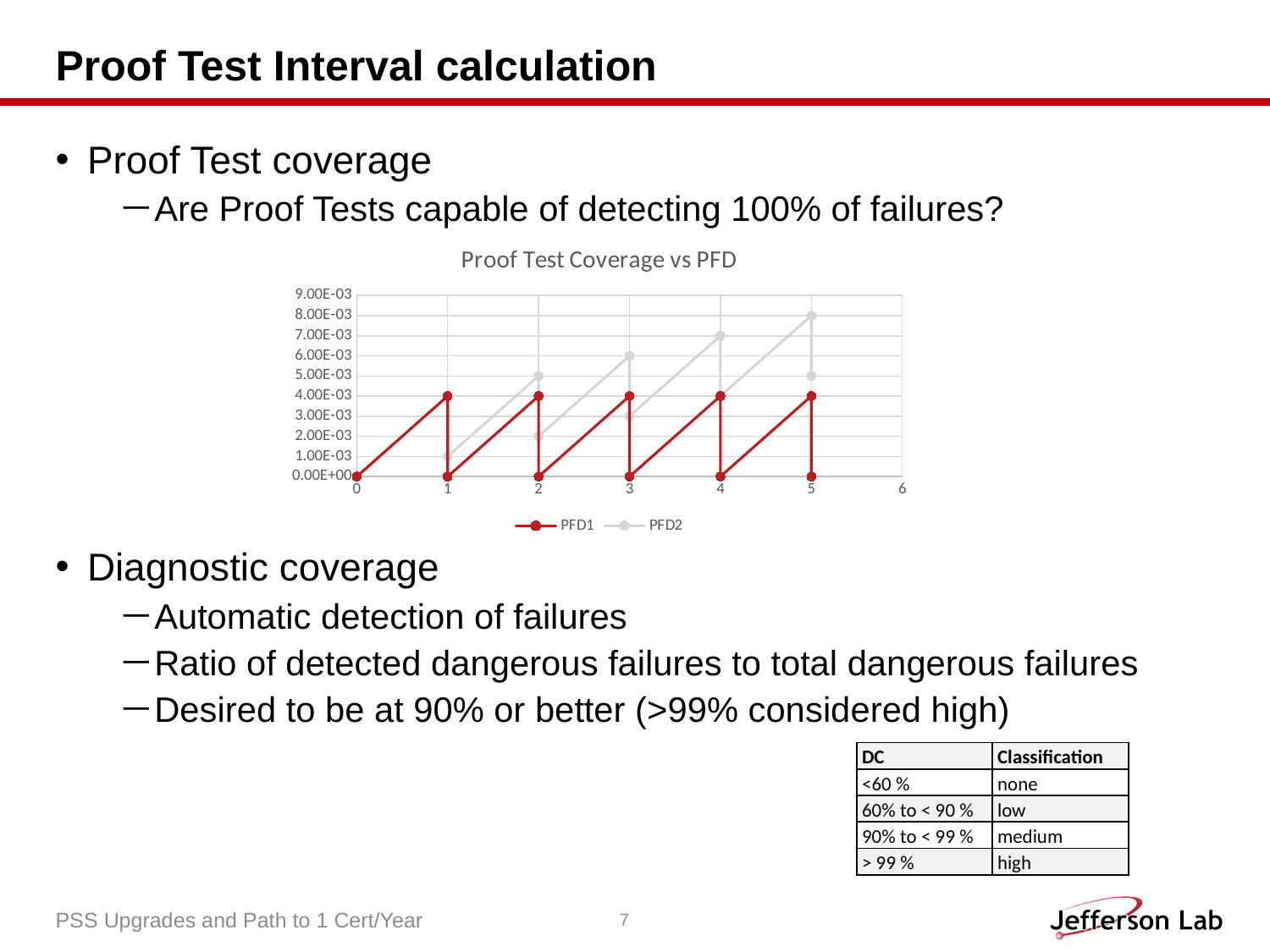
What are the two series named in the legend of the 'Proof Test Coverage vs PFD' chart? PFD1 and PFD2 In the 'Proof Test Coverage vs PFD' chart, what is the highest value PFD2 reaches (at x = 5)? 8.00E-03 In the 'Proof Test Coverage vs PFD' chart, what is the difference between the PFD2 peak at x = 5 and the PFD1 peak at x = 5? 4.00E-03 In the 'Proof Test Coverage vs PFD' chart, which series reaches the highest value? PFD2 What colour is the PFD1 line in the 'Proof Test Coverage vs PFD' chart? red How many series does the legend of the 'Proof Test Coverage vs PFD' chart list? 2 In the 'Proof Test Coverage vs PFD' chart, what is the peak value that PFD1 reaches at each interval? 4.00E-03 In the 'Proof Test Coverage vs PFD' chart, do the peaks of PFD2 rise or fall as x increases? rise In the 'Proof Test Coverage vs PFD' chart, what value does PFD2 drop to at x = 1? 1.00E-03 What kind of chart is 'Proof Test Coverage vs PFD'? line chart In the 'Proof Test Coverage vs PFD' chart, at x = 3 which series has the higher peak, PFD1 or PFD2? PFD2 In the 'Proof Test Coverage vs PFD' chart, is the peak value of PFD2 at x = 5 greater or less than 6.00E-03? greater